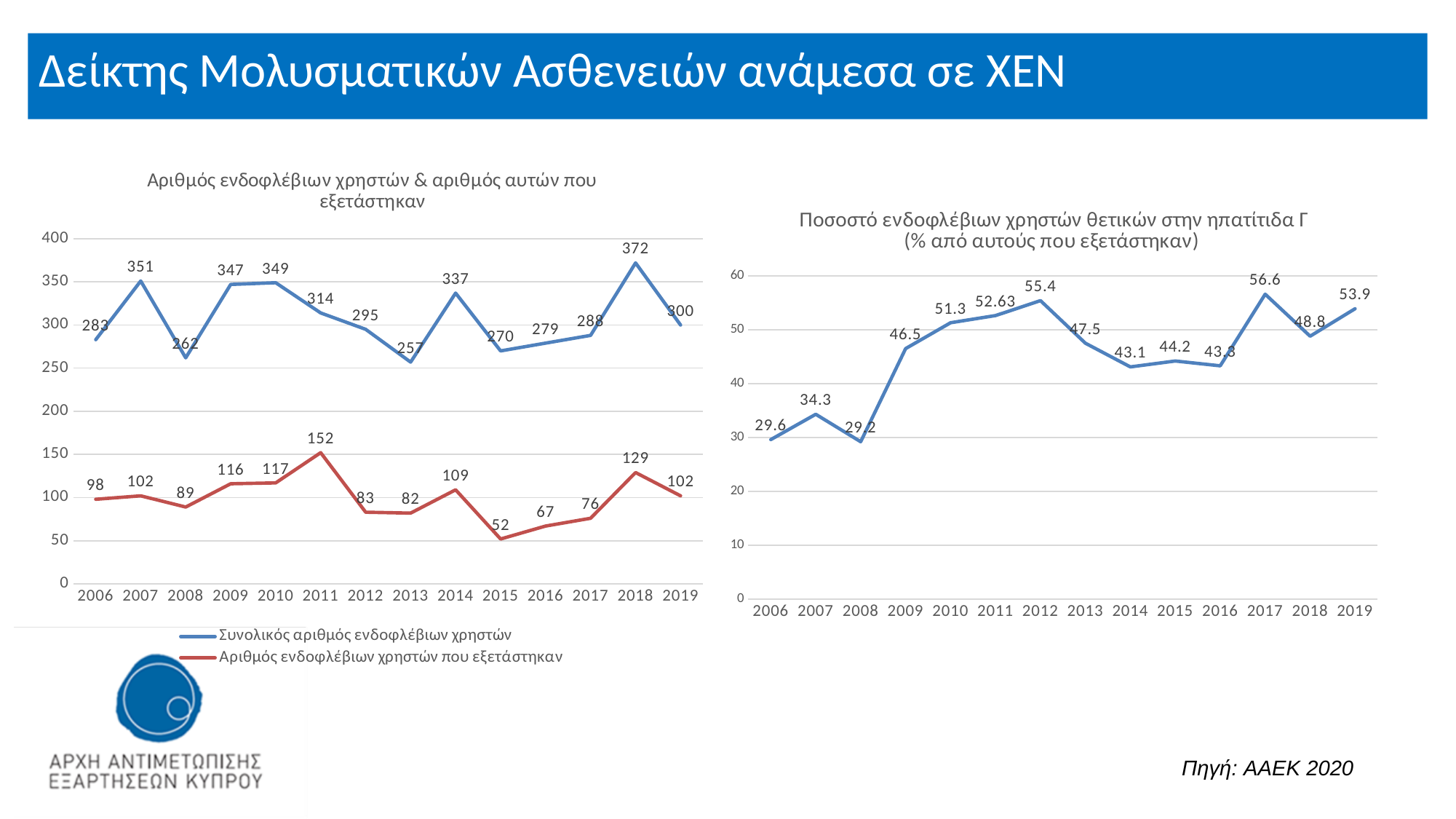
In the left chart, what is the difference between the total number of intravenous users and the number examined in 2019? 198 What type of chart is the left chart? Line chart In the left chart, in which year is the number of intravenous users examined lowest? 2015 How many years are plotted on the x axis of the right chart? 14 In the right chart, is the value for 2012 greater or less than the value for 2013? greater How many series does the legend of the left chart list? 2 In the left chart, what is the total number of intravenous users (Συνολικός αριθμός ενδοφλέβιων χρηστών) in 2018? 372 In the right chart, in which year is the percentage positive for hepatitis C lowest? 2008 In the left chart, in which year is the total number of intravenous users highest? 2018 In the right chart, what is the difference between the 2019 value and the 2018 value? 5.1 In the right chart, what is the percentage of intravenous users positive for hepatitis C in 2017? 56.6 In the left chart, what is the number of intravenous users examined (Αριθμός ενδοφλέβιων χρηστών που εξετάστηκαν) in 2011? 152